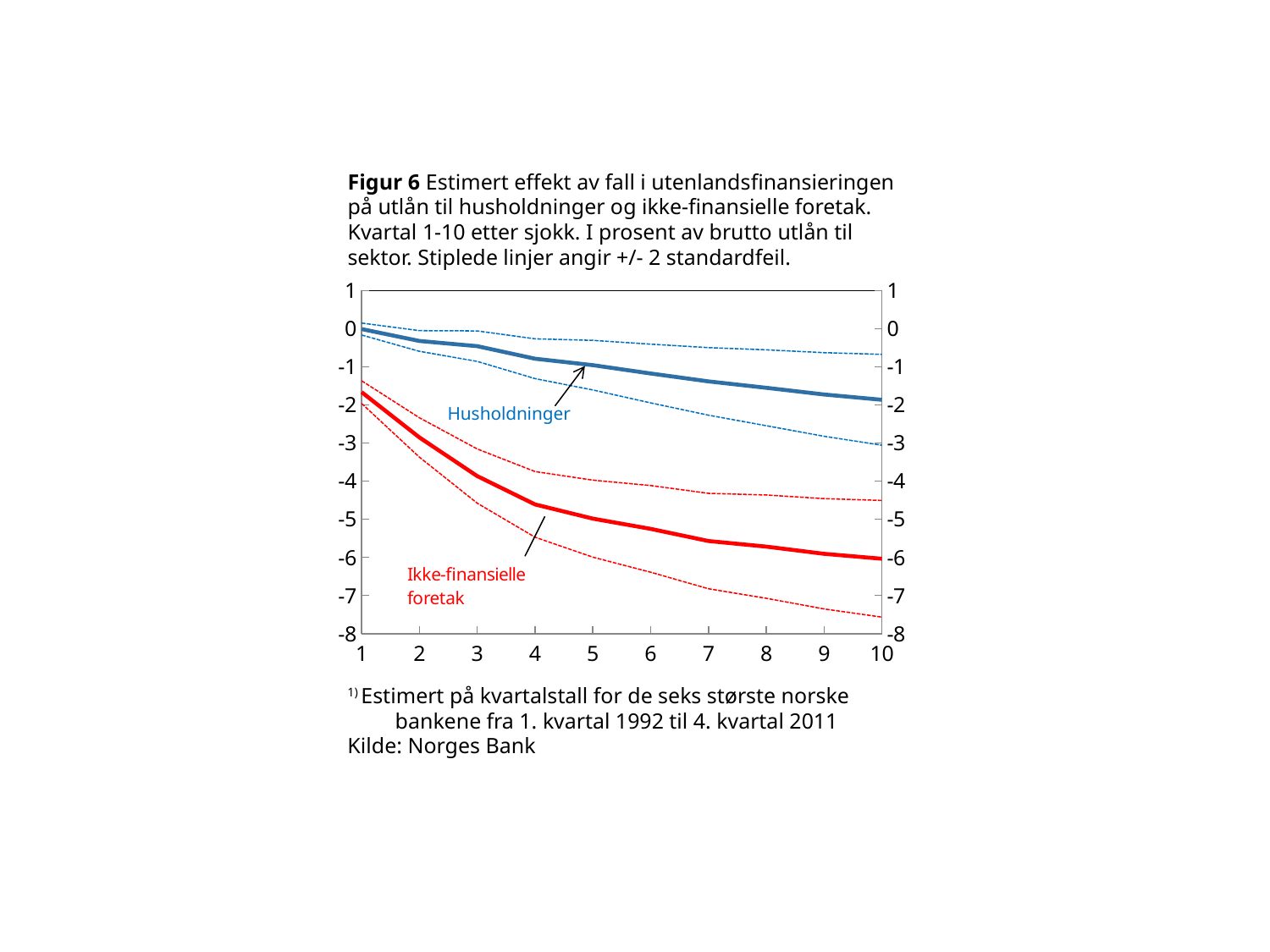
Does the Ikke-finansielle foretak line rise or fall from quarter 1 to quarter 10? fall Is the value for Ikke-finansielle foretak at quarter 1 greater or less than -1? less What is the figure number given in the chart title? Figur 6 What source is cited below the chart? Norges Bank What kind of chart is shown on the slide? line chart At quarter 10, which series has the higher value, Husholdninger or Ikke-finansielle foretak? Husholdninger Is the value for Husholdninger at quarter 10 greater or less than -1? less Is the value for Ikke-finansielle foretak at quarter 4 greater or less than -4? less How many quarters are shown along the x axis of the chart? 10 Does the Husholdninger line rise or fall from quarter 1 to quarter 10? fall Which series reaches the lowest value on the chart? Ikke-finansielle foretak